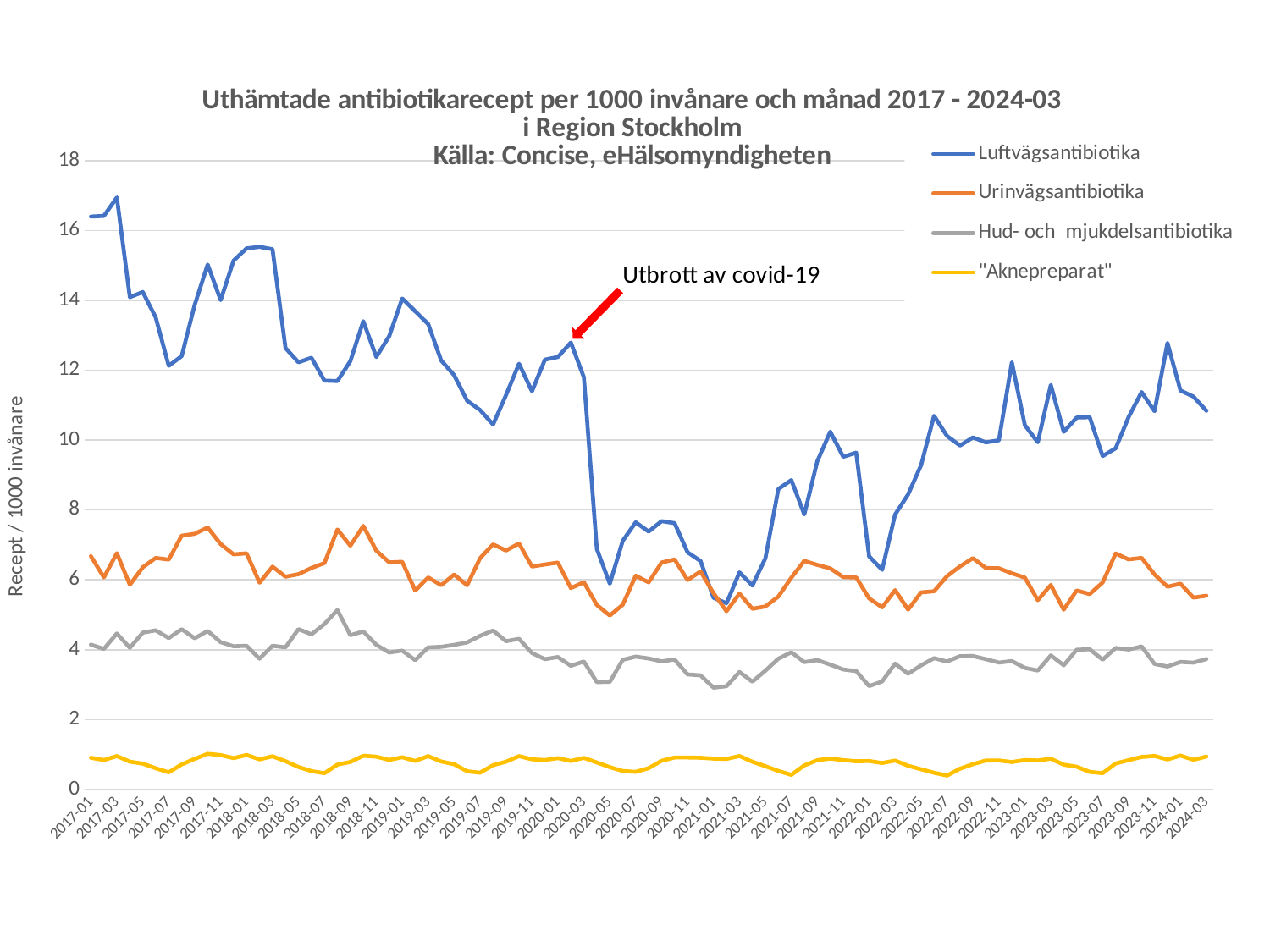
What event does the red arrow annotation on the chart point to? Utbrott av covid-19 Is the value for Luftvägsantibiotika in 2017-03 greater or less than 16? greater Is the value for Luftvägsantibiotika in 2020-05 greater or less than 8? less How many series does the legend list? 4 Which series has the highest value in 2024-03? Luftvägsantibiotika In 2017-01, which is larger: Luftvägsantibiotika or Urinvägsantibiotika? Luftvägsantibiotika Is the value for "Aknepreparat" in 2019-01 greater or less than 2? less Does the Luftvägsantibiotika series rise or fall from 2017-01 to 2020-05? fall Which series has the lowest values throughout the whole period? "Aknepreparat" What is the label on the vertical axis of the chart? Recept / 1000 invånare What kind of chart is shown on the slide? line chart